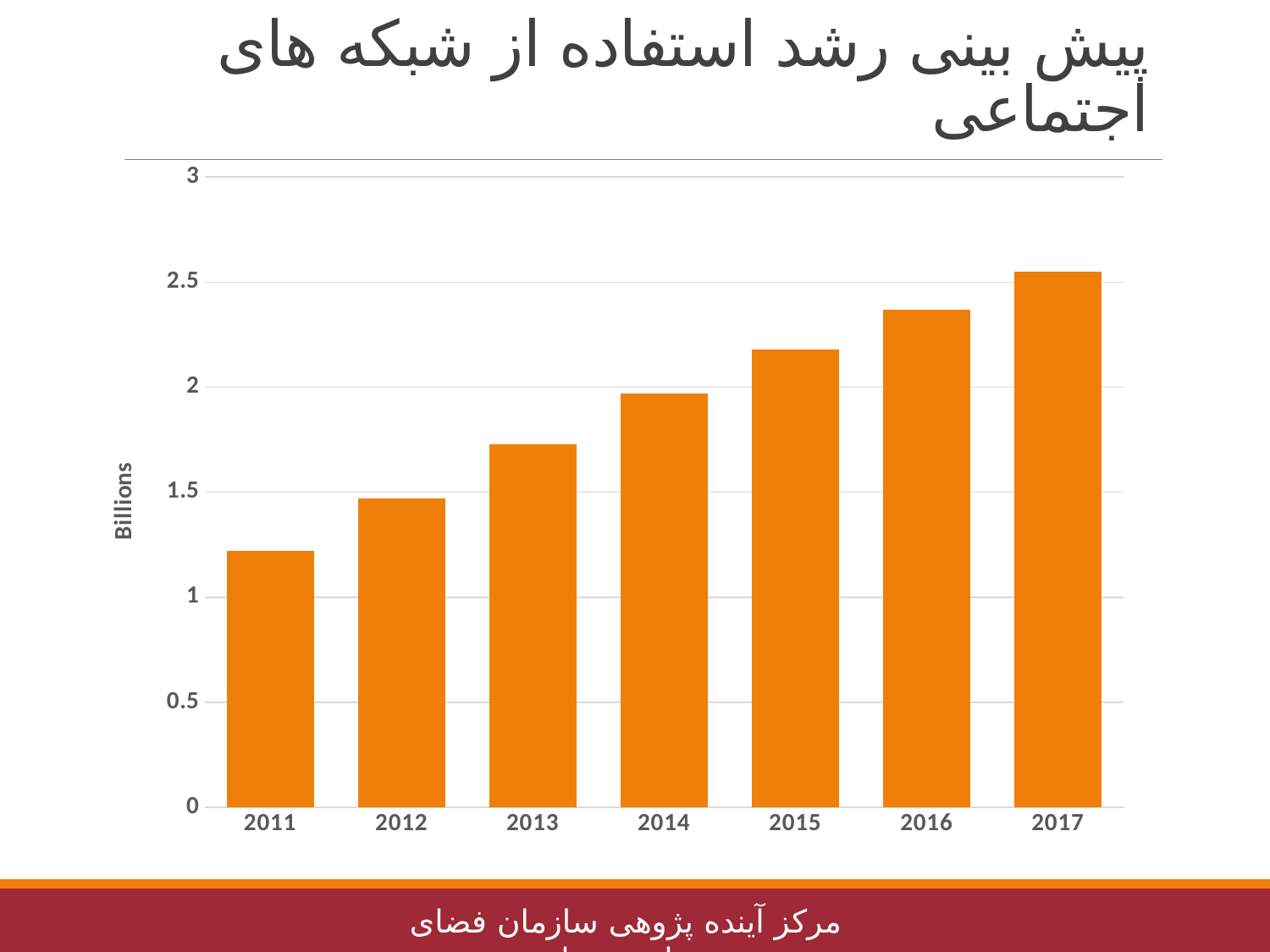
Is the value for 2015 greater or less than 2? greater Which year has the lowest bar in the chart? 2011 Is the value for 2016 greater or less than 2.5? less Which year has the highest bar in the chart? 2017 What colour are the bars in the chart? orange What kind of chart is shown on the slide? bar chart Which is larger, the value for 2014 or the value for 2012? 2014 What is the label on the vertical axis of the chart? Billions Is the value for 2011 greater or less than 1.5? less How many years are shown on the x axis of the chart? 7 Do the values rise or fall from 2011 to 2017? rise